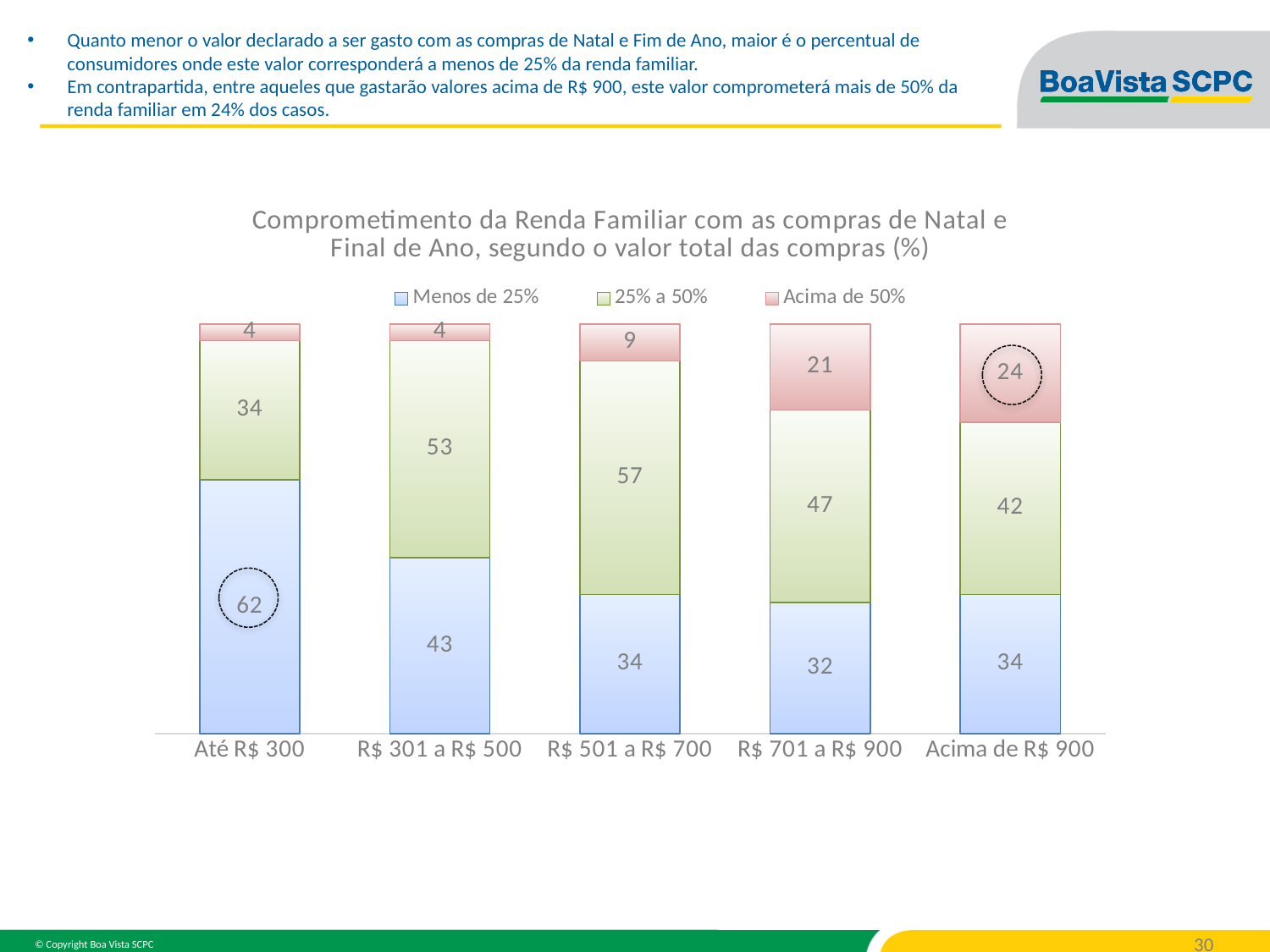
Which category has the lowest value for 'Menos de 25%'? R$ 701 a R$ 900 What is the value of 'Acima de 50%' for 'Acima de R$ 900'? 24 What is the difference between the 'Acima de 50%' values for 'Acima de R$ 900' and 'Até R$ 300'? 20 Which is larger: the '25% a 50%' value for 'R$ 301 a R$ 500' or for 'R$ 701 a R$ 900'? R$ 301 a R$ 500 How many categories are shown on the x axis? 5 Does the 'Acima de 50%' series rise or fall from 'Até R$ 300' to 'Acima de R$ 900'? Rise What type of chart is shown on the slide? Stacked bar chart What is the total of the stacked bar for 'R$ 701 a R$ 900'? 100 What is the value of 'Menos de 25%' for 'Até R$ 300'? 62 What is the value of '25% a 50%' for 'R$ 501 a R$ 700'? 57 How many series does the legend list? 3 Which category has the highest value for 'Menos de 25%'? Até R$ 300